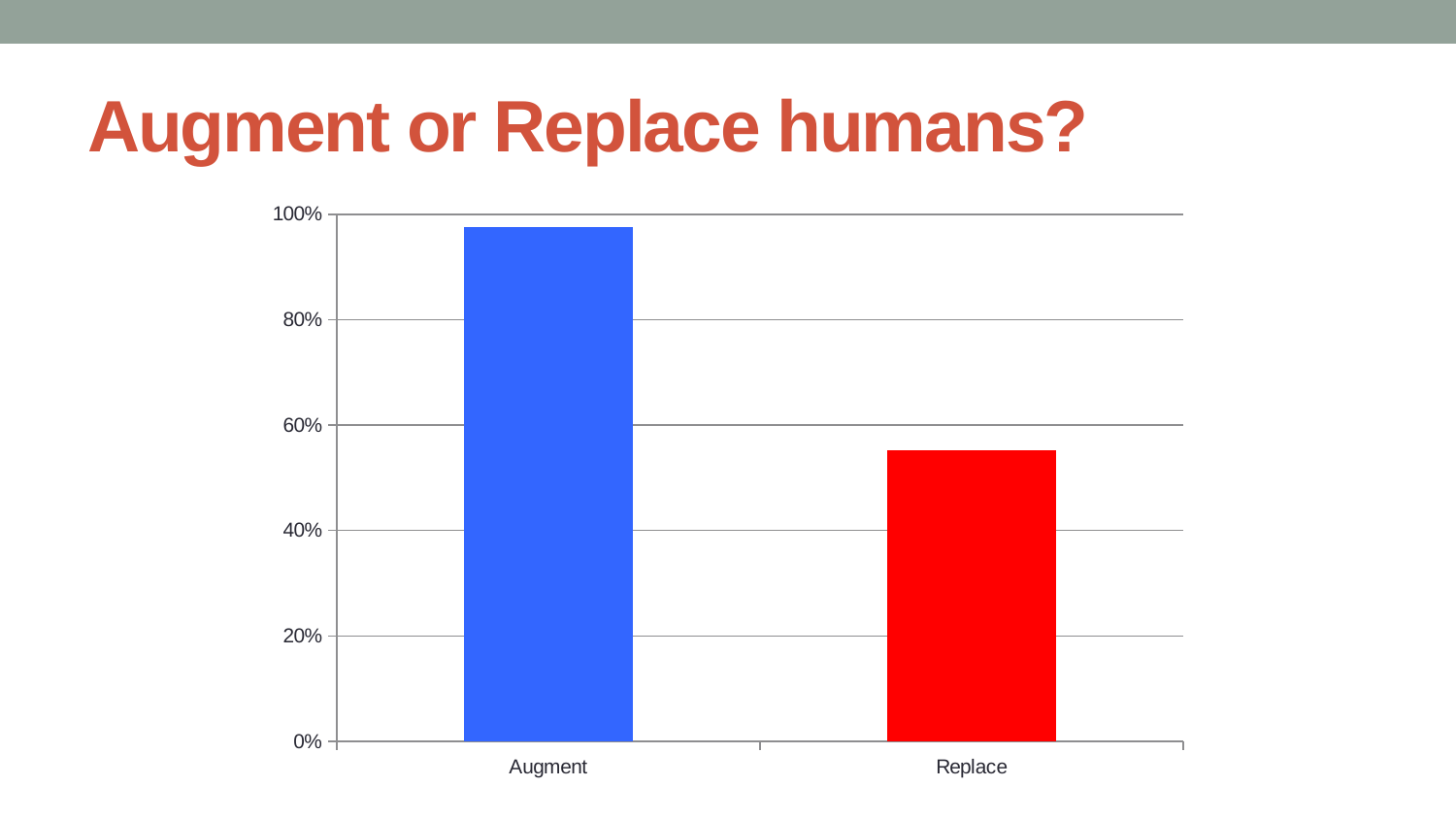
Which category has the lowest value? Replace What is the highest tick label on the y axis? 100% Is the value for Replace greater or less than 40%? greater Is the value for Augment greater or less than 80%? greater Which is larger, the value for Augment or the value for Replace? Augment What colour is the bar for Replace? red What is the title of the slide containing the chart? Augment or Replace humans? Is the value for Replace greater or less than 60%? less Which category has the highest value? Augment What kind of chart is shown on the slide? bar chart How many categories are shown on the x axis? 2